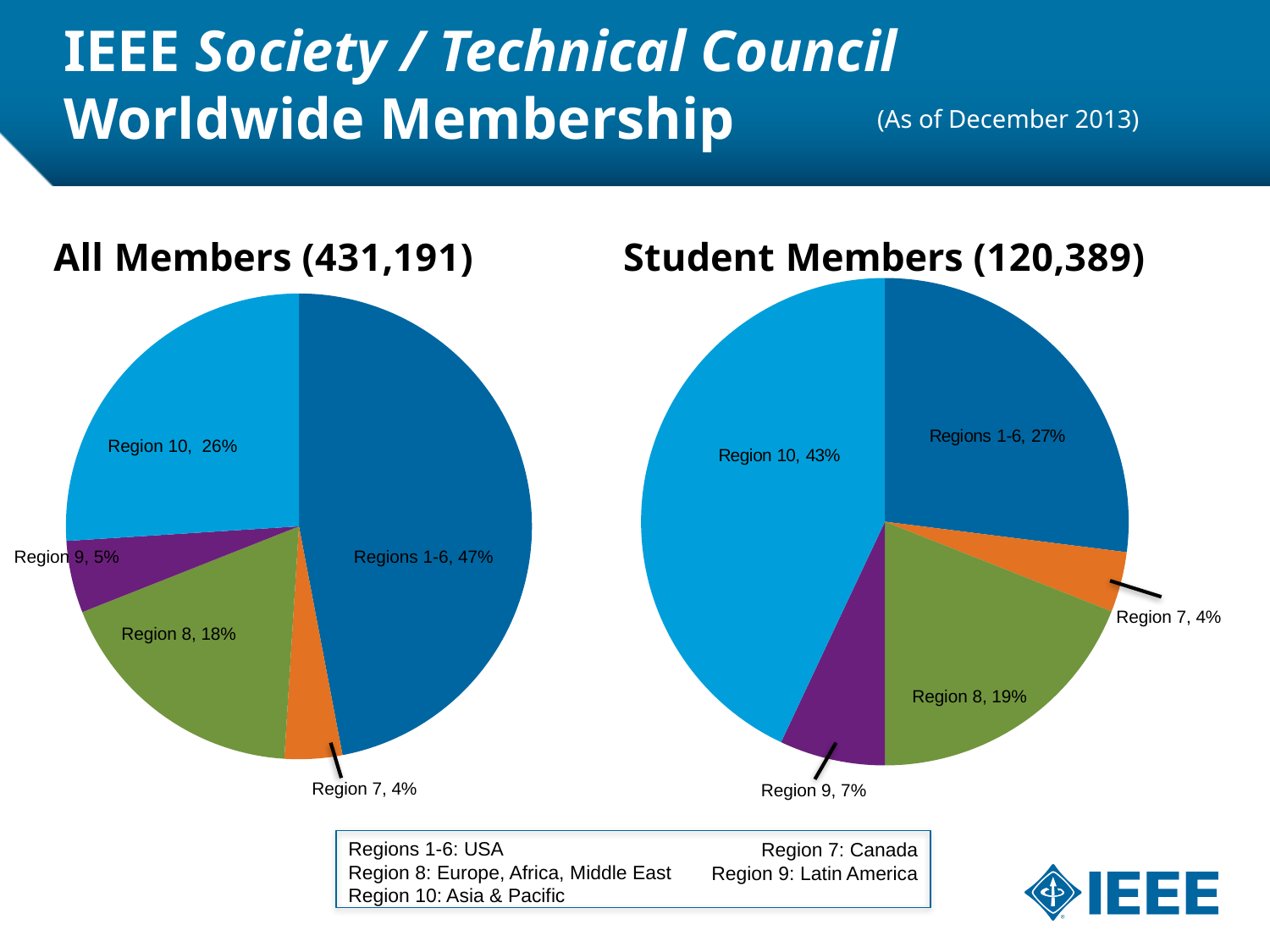
In the All Members pie chart, what is the difference in percentage points between Regions 1-6 and Region 10? 21 What type of chart is used for Student Members? Pie chart In the Student Members pie chart, which is larger: the share of Region 8 or the share of Regions 1-6? Regions 1-6 How many slices does the All Members pie chart have? 5 In the All Members pie chart, what share does Region 8 hold? 18% In the All Members pie chart, which region has the largest share? Regions 1-6 In the Student Members pie chart, which region has the smallest share? Region 7 In the Student Members pie chart, what share does Region 10 hold? 43% What total membership number is shown in the title of the Student Members chart? 120,389 In the Student Members pie chart, what share does Region 9 hold? 7% According to the legend box, which area does Region 9 represent? Latin America In the All Members pie chart, what share do Regions 1-6 hold? 47%